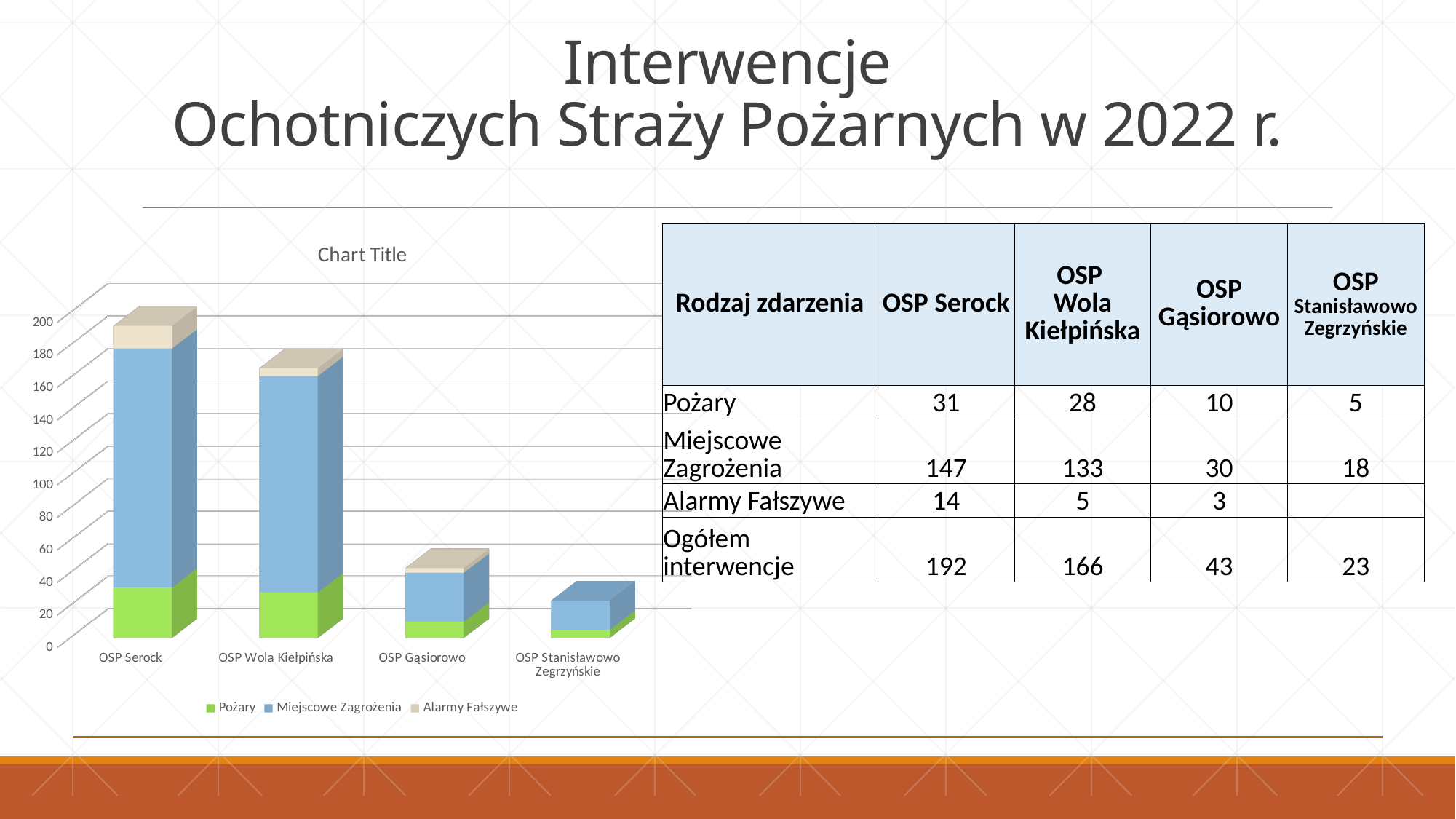
Which series is shown in green in the chart's legend? Pożary How many OSP units are shown as categories on the chart's x axis? 4 Is the total height of the stacked bar for OSP Serock greater or less than 180? greater What is the value of Miejscowe Zagrożenia for OSP Wola Kiełpińska? 133 Which OSP unit has the tallest stacked bar in the chart? OSP Serock How many series does the chart's legend list? 3 Do the total stacked bar heights rise or fall from left to right along the x axis? fall Which OSP unit has the shortest stacked bar in the chart? OSP Stanisławowo Zegrzyńskie What is the difference between the Pożary values for OSP Serock and OSP Wola Kiełpińska? 3 What is the total of the stacked bar (Ogółem interwencje) for OSP Gąsiorowo? 43 Is the total height of the stacked bar for OSP Gąsiorowo greater or less than 60? less What kind of chart is shown on the slide? bar chart